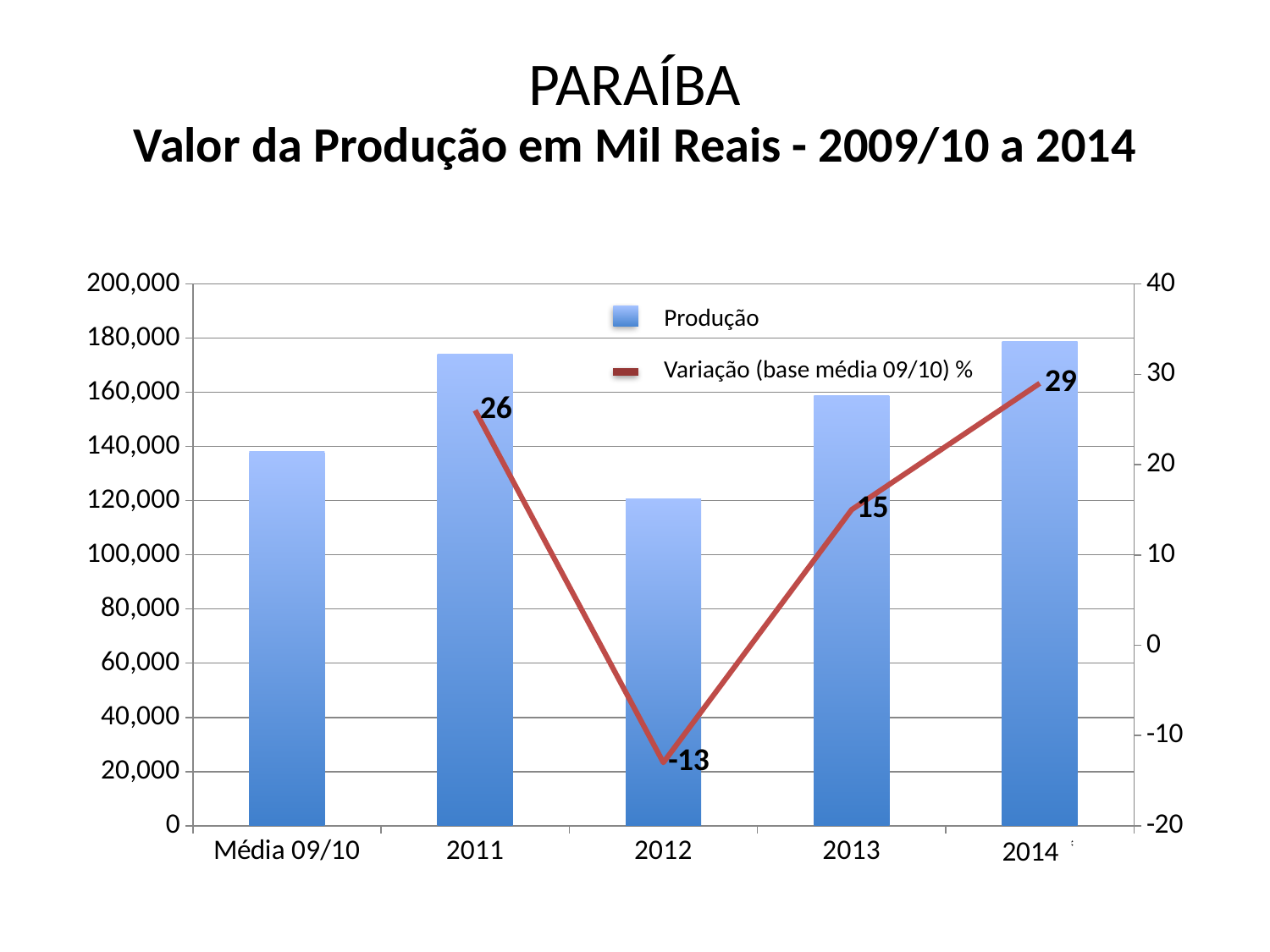
Is the Produção value for 2012 greater or less than 140,000? less Is the Produção value for 2011 greater or less than 160,000? greater What is the Variação (base média 09/10) % value for 2012? -13 Which category has the lowest Produção bar? 2012 In which year is the Variação (base média 09/10) % lowest? 2012 In which year is the Variação (base média 09/10) % highest? 2014 What is the difference between the Variação values for 2014 and 2013? 14 What is the Variação (base média 09/10) % value for 2014? 29 How many categories are shown on the x axis? 5 Which year has the larger Variação value, 2011 or 2013? 2011 How many series does the legend list? 2 What is the Variação (base média 09/10) % value for 2011? 26